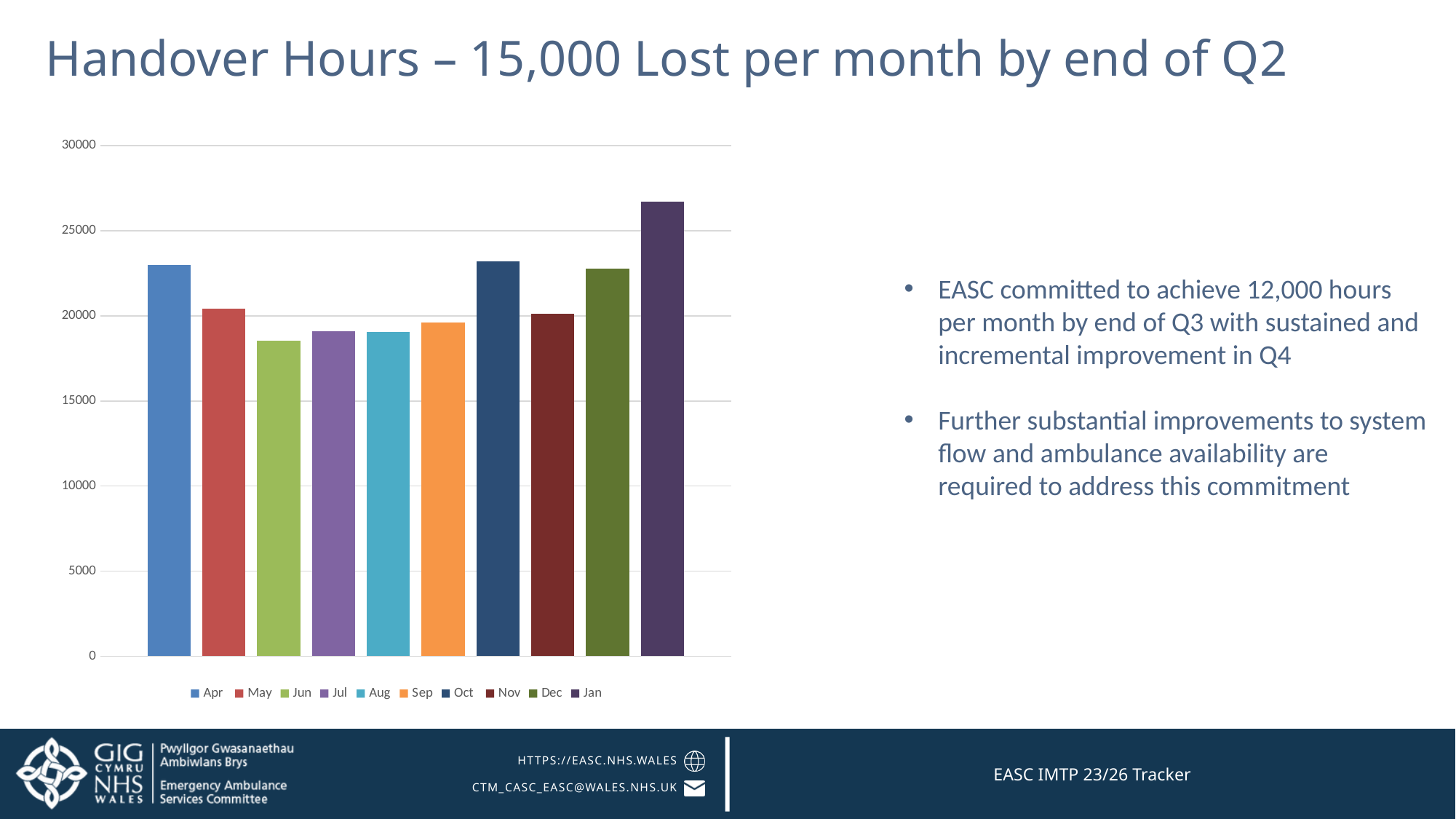
Is the value for Jan greater or less than 25000? greater Which is larger, the value for Dec or the value for Jun? Dec From Apr to Jun, do the values rise or fall? Fall Is the value for Aug greater or less than 20000? less Which is larger, the value for Jan or the value for Apr? Jan How many months are plotted in the chart? 10 Is the value for Oct greater or less than 20000? greater How many entries does the chart legend list? 10 What is the title of the slide containing the chart? Handover Hours – 15,000 Lost per month by end of Q2 What kind of chart is shown on the slide? Bar chart Which month has the highest value in the chart? Jan